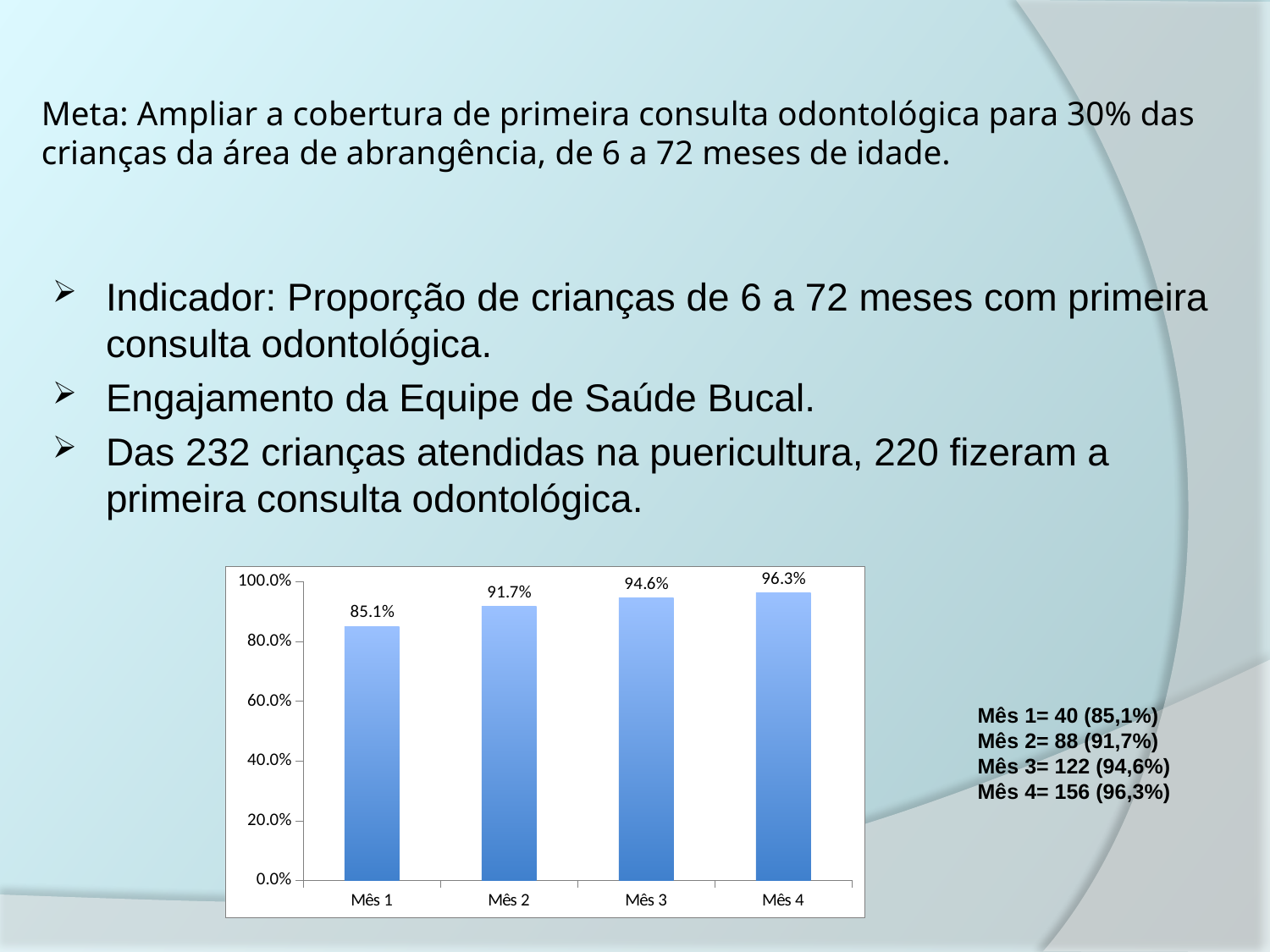
What is the value for Mês 4? 96.3% What is the value for Mês 1? 85.1% What is the value for Mês 3? 94.6% Which month has the highest value? Mês 4 What is the difference between the values for Mês 2 and Mês 1? 6.6% Which is larger, the value for Mês 2 or the value for Mês 3? Mês 3 What is the difference between the values for Mês 4 and Mês 1? 11.2% Which month has the lowest value? Mês 1 Do the values rise or fall from Mês 1 to Mês 4? rise Is the value for Mês 1 greater or less than 80.0%? greater How many months are shown on the x axis? 4 What kind of chart is shown on the slide? bar chart